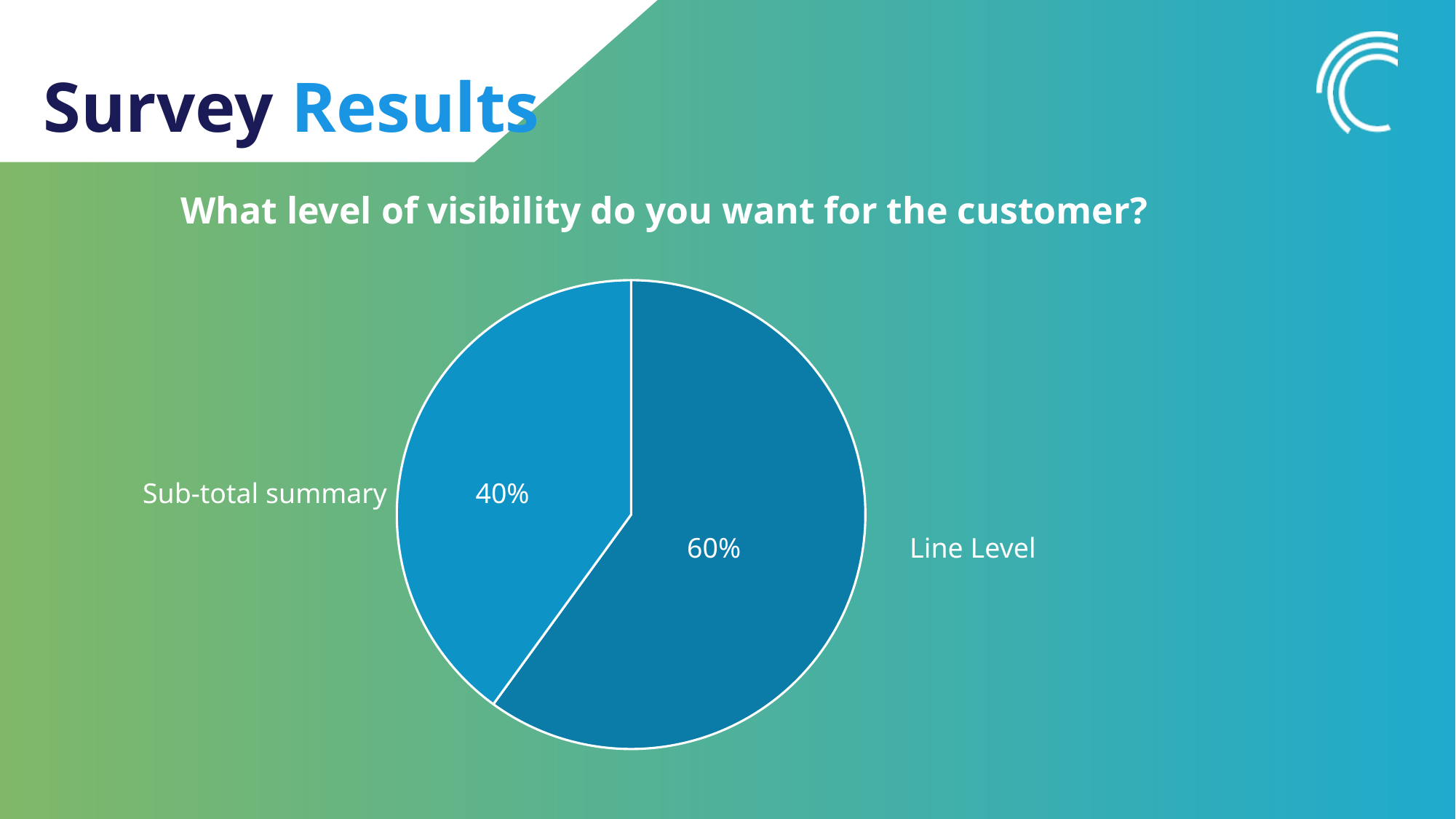
Which slice of the pie is the smallest? Sub-total summary What share of the pie does Line Level represent? 60% What question does the chart's title ask? What level of visibility do you want for the customer? What kind of chart is shown on the slide? pie chart Which is larger, the Line Level slice or the Sub-total summary slice? Line Level What is the difference in percentage points between the Line Level and Sub-total summary slices? 20% Is the Line Level slice greater or less than 50% of the pie? greater How many slices does the pie chart have? 2 Which slice of the pie is the largest? Line Level What share of the pie does Sub-total summary represent? 40%